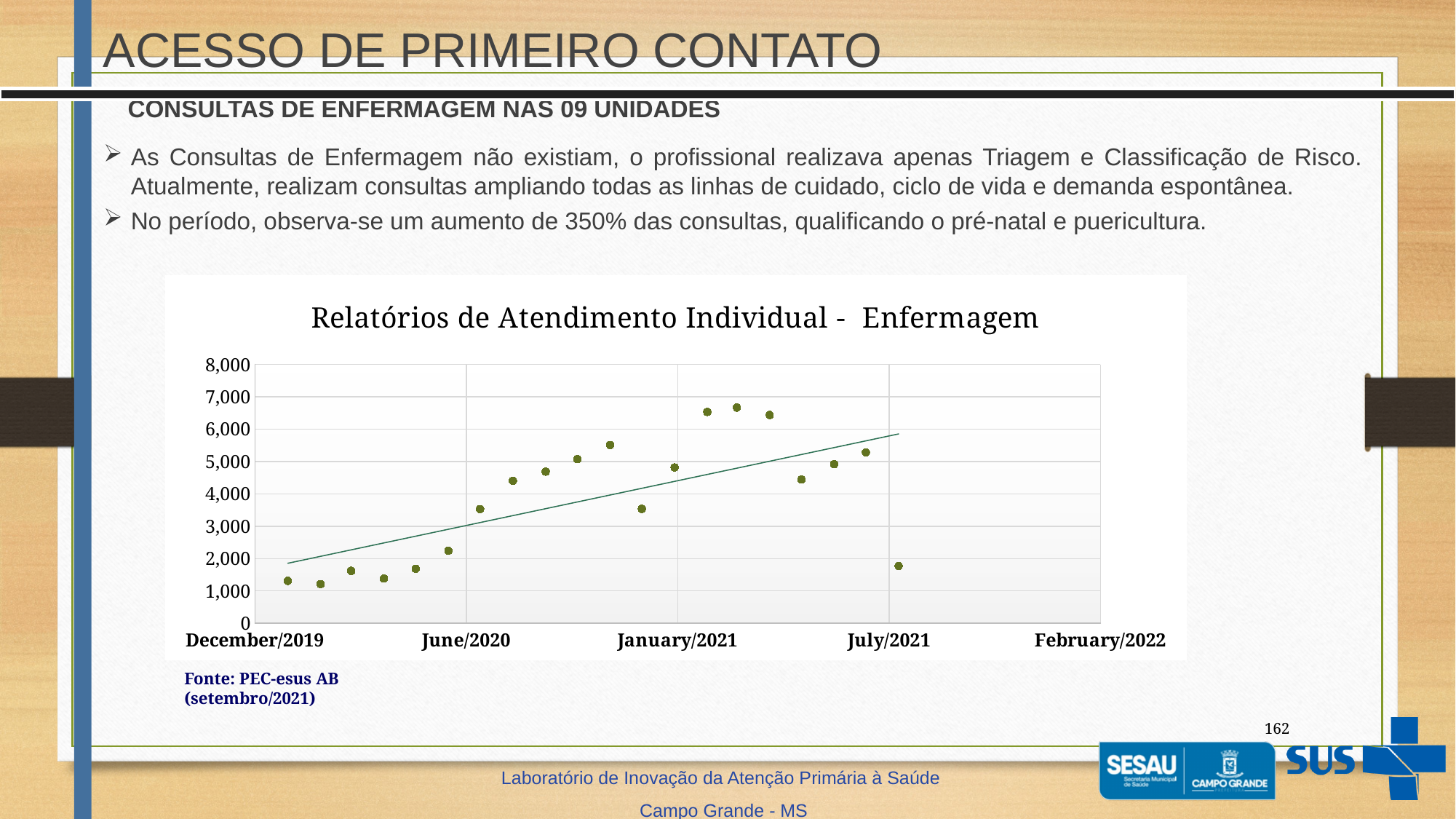
Is the value for January/2021 greater or less than 6,000? less What is the title of the chart? Relatórios de Atendimento Individual - Enfermagem Does the trend line in the chart rise or fall from left to right? rise What is the highest value shown on the vertical axis? 8,000 What kind of chart is shown on the slide? scatter chart How many data points are plotted in the chart? 20